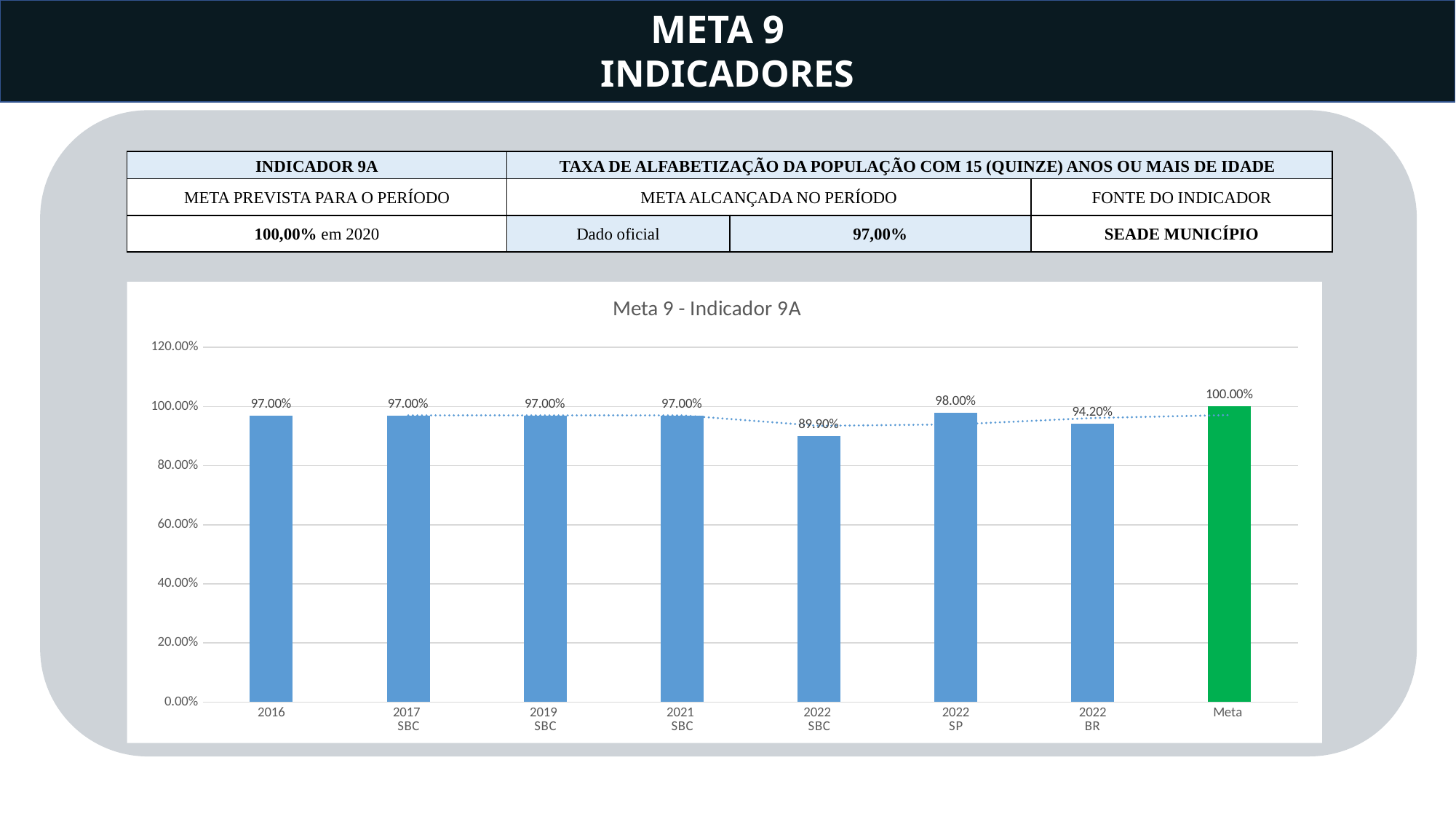
What is the difference between the value for 2022 SP and the value for 2022 SBC? 8.10% What is the value for Meta? 100.00% What is the value for 2022 SBC? 89.90% What is the value for 2022 BR? 94.20% Which category has the lowest value? 2022 SBC What is the value for 2016? 97.00% Which is larger, the value for 2022 SP or the value for 2022 BR? 2022 SP What kind of chart is shown on the slide? bar chart How many bars are shown in the chart? 8 What is the title of the chart? Meta 9 - Indicador 9A Is the value for 2022 SBC greater or less than 80.00%? greater Which category has the highest value? Meta